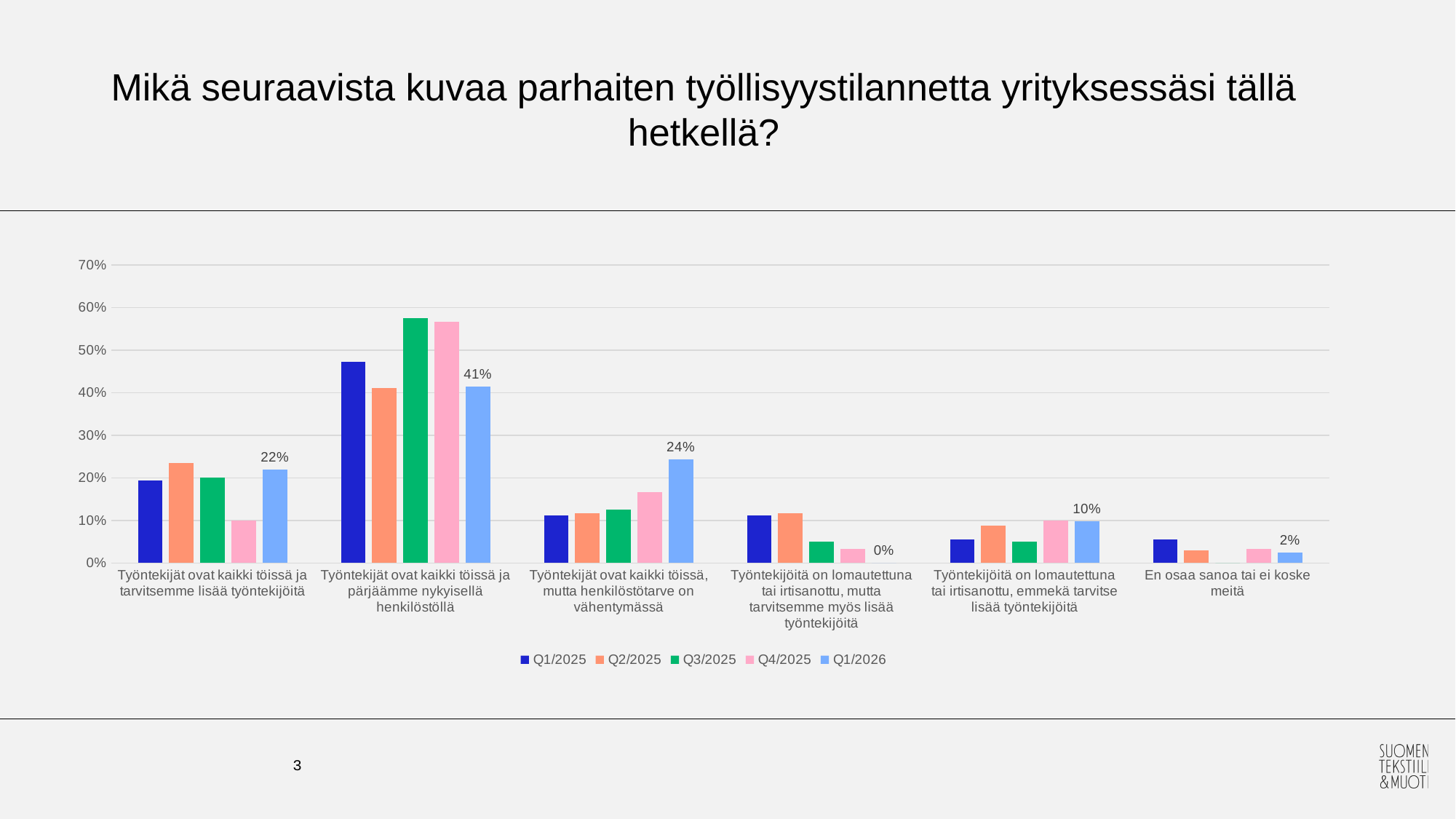
Is the Q3/2025 value for "Työntekijät ovat kaikki töissä ja pärjäämme nykyisellä henkilöstöllä" greater or less than 50%? greater What kind of chart is shown on the slide? bar chart How many categories are shown on the x axis? 6 How many series does the legend list? 5 What is the difference between the Q1/2026 values for "Työntekijät ovat kaikki töissä ja pärjäämme nykyisellä henkilöstöllä" and "Työntekijät ovat kaikki töissä ja tarvitsemme lisää työntekijöitä"? 19 percentage points What is the Q1/2026 value for "Työntekijät ovat kaikki töissä ja pärjäämme nykyisellä henkilöstöllä"? 41% What is the Q1/2026 value for "Työntekijät ovat kaikki töissä, mutta henkilöstötarve on vähentymässä"? 24% For Q1/2026, which is larger: "Työntekijät ovat kaikki töissä ja tarvitsemme lisää työntekijöitä" or "Työntekijät ovat kaikki töissä, mutta henkilöstötarve on vähentymässä"? Työntekijät ovat kaikki töissä, mutta henkilöstötarve on vähentymässä What is the Q1/2026 value for "En osaa sanoa tai ei koske meitä"? 2% Which category has the lowest Q1/2026 value? Työntekijöitä on lomautettuna tai irtisanottu, mutta tarvitsemme myös lisää työntekijöitä Which category has the highest Q1/2026 value? Työntekijät ovat kaikki töissä ja pärjäämme nykyisellä henkilöstöllä What is the Q1/2026 value for "Työntekijöitä on lomautettuna tai irtisanottu, mutta tarvitsemme myös lisää työntekijöitä"? 0%